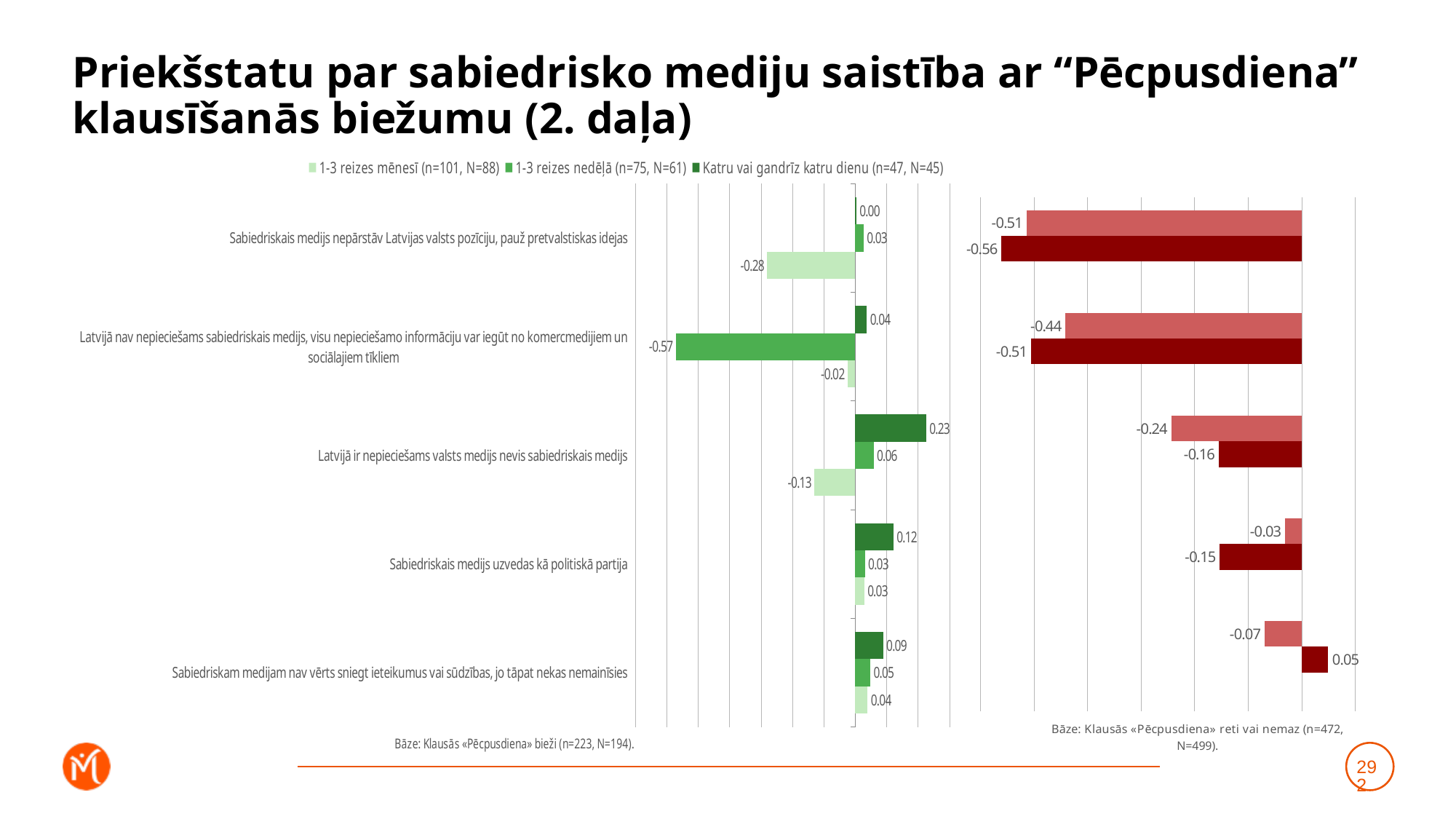
What type of chart is used on this slide? bar chart In the left chart (Bāze: Klausās «Pēcpusdiena» bieži), which statement has the highest value for "Katru vai gandrīz katru dienu"? Latvijā ir nepieciešams valsts medijs nevis sabiedriskais medijs In the left chart (Bāze: Klausās «Pēcpusdiena» bieži), what is the value for "Katru vai gandrīz katru dienu" for the statement "Latvijā ir nepieciešams valsts medijs nevis sabiedriskais medijs"? 0.23 In the left chart (Bāze: Klausās «Pēcpusdiena» bieži), what is the value for "1-3 reizes nedēļā" for the statement "Latvijā nav nepieciešams sabiedriskais medijs, visu nepieciešamo informāciju var iegūt no komercmedijiem un sociālajiem tīkliem"? -0.57 In the left chart (Bāze: Klausās «Pēcpusdiena» bieži), how many series does the legend list? 3 In the right chart (Bāze: Klausās «Pēcpusdiena» reti vai nemaz), what is the dark red value for the statement "Sabiedriskais medijs nepārstāv Latvijas valsts pozīciju, pauž pretvalstiskas idejas"? -0.56 In the left chart (Bāze: Klausās «Pēcpusdiena» bieži), what is the value for "1-3 reizes mēnesī" for the statement "Sabiedriskais medijs nepārstāv Latvijas valsts pozīciju, pauž pretvalstiskas idejas"? -0.28 In the right chart (Bāze: Klausās «Pēcpusdiena» reti vai nemaz), which statement has the only positive value? Sabiedriskam medijam nav vērts sniegt ieteikumus vai sūdzības, jo tāpat nekas nemainīsies In the right chart (Bāze: Klausās «Pēcpusdiena» reti vai nemaz), what is the lighter red value for the statement "Latvijā nav nepieciešams sabiedriskais medijs, visu nepieciešamo informāciju var iegūt no komercmedijiem un sociālajiem tīkliem"? -0.44 In the right chart (Bāze: Klausās «Pēcpusdiena» reti vai nemaz), which is larger for "Sabiedriskais medijs uzvedas kā politiskā partija": the lighter red value or the dark red value? the lighter red value (-0.03) In the left chart (Bāze: Klausās «Pēcpusdiena» bieži), what is the difference between the "Katru vai gandrīz katru dienu" value (0.23) and the "1-3 reizes mēnesī" value (-0.13) for "Latvijā ir nepieciešams valsts medijs nevis sabiedriskais medijs"? 0.36 How many statements (categories) are shown in the left chart (Bāze: Klausās «Pēcpusdiena» bieži)? 5